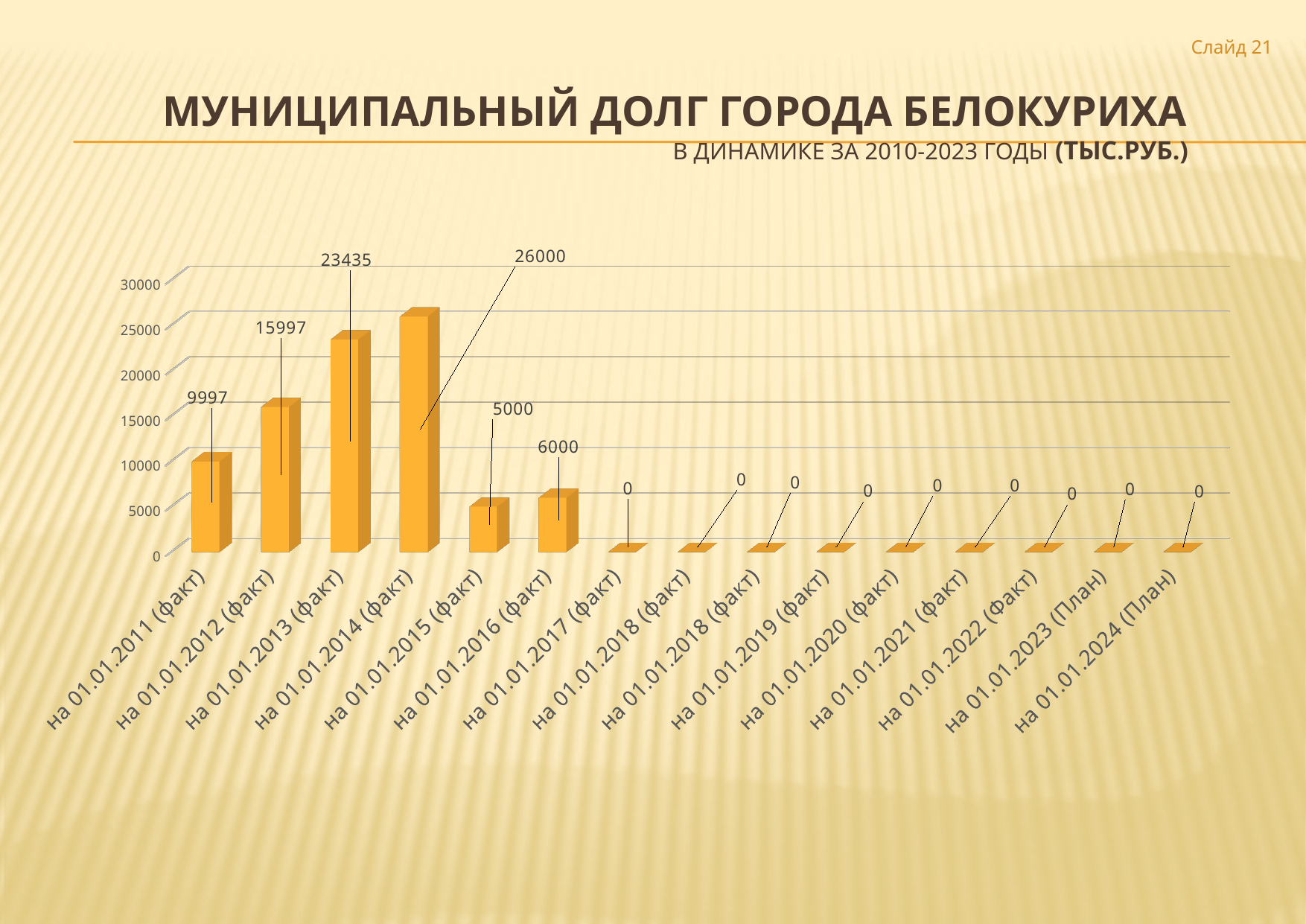
Which category has the highest value? на 01.01.2014 (факт) What is the value shown for на 01.01.2013 (факт)? 23435 What is the municipal debt value for на 01.01.2014 (факт)? 26000 How many categories are shown on the x axis? 15 What is the difference between the values for на 01.01.2012 (факт) and на 01.01.2011 (факт)? 6000 What is the value shown for на 01.01.2016 (факт)? 6000 What is the value shown for на 01.01.2011 (факт)? 9997 What is the value shown for на 01.01.2024 (План)? 0 Which is larger, the value for на 01.01.2015 (факт) or на 01.01.2016 (факт)? на 01.01.2016 (факт) What kind of chart is shown on the slide? bar chart Is the value for на 01.01.2013 (факт) greater or less than 20000? greater What is the difference between the values for на 01.01.2014 (факт) and на 01.01.2013 (факт)? 2565